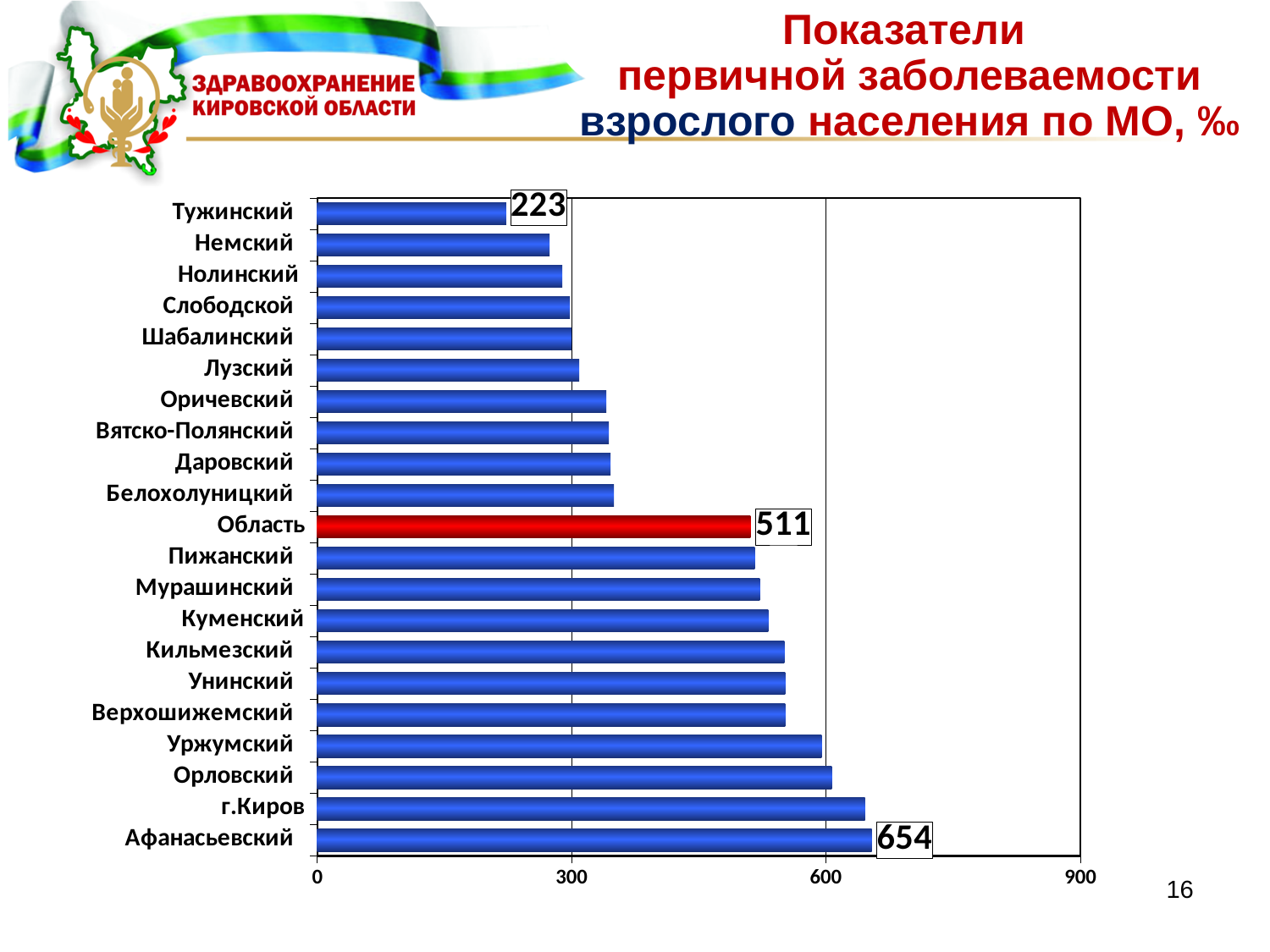
What is the value for Область? 511 What is the value for Тужинский? 223 Is the value for г.Киров greater or less than 600? greater Which is larger, the value for г.Киров or the value for Орловский? г.Киров What is the difference between the values for Афанасьевский and Тужинский? 431 How many categories are shown on the chart? 21 What kind of chart is shown on the slide? bar chart What is the value for Афанасьевский? 654 Which category has the highest value? Афанасьевский What is the difference between the values for Афанасьевский and Область? 143 Which category has the lowest value? Тужинский Is the value for Немский greater or less than 300? less